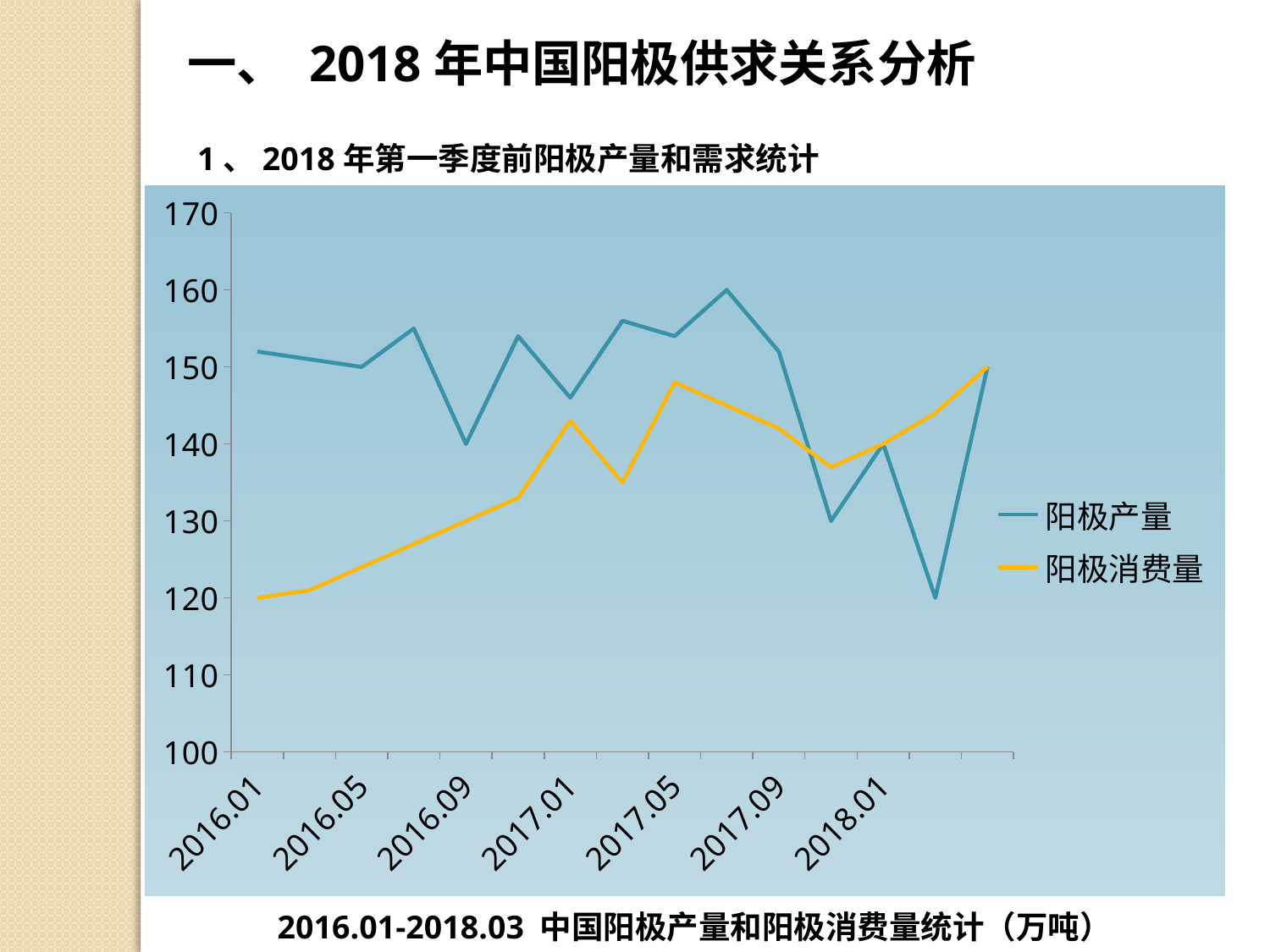
Is the value of 阳极产量 at 2017.01 greater or less than 150? less Does the 阳极消费量 line generally rise or fall from 2016.01 to the end of the period? rise Is the value of 阳极消费量 at 2016.01 greater or less than 130? less Does the 阳极产量 line rise or fall between 2017.09 and 2017.11? fall How many series does the chart's legend list? 2 At 2016.01, which series has the larger value, 阳极产量 or 阳极消费量? 阳极产量 What kind of chart is shown on the slide? line chart What are the two series named in the legend? 阳极产量 and 阳极消费量 Is the value of 阳极消费量 at 2017.09 greater or less than 150? less Which series is drawn in yellow? 阳极消费量 At 2017.09, which series has the larger value, 阳极产量 or 阳极消费量? 阳极产量